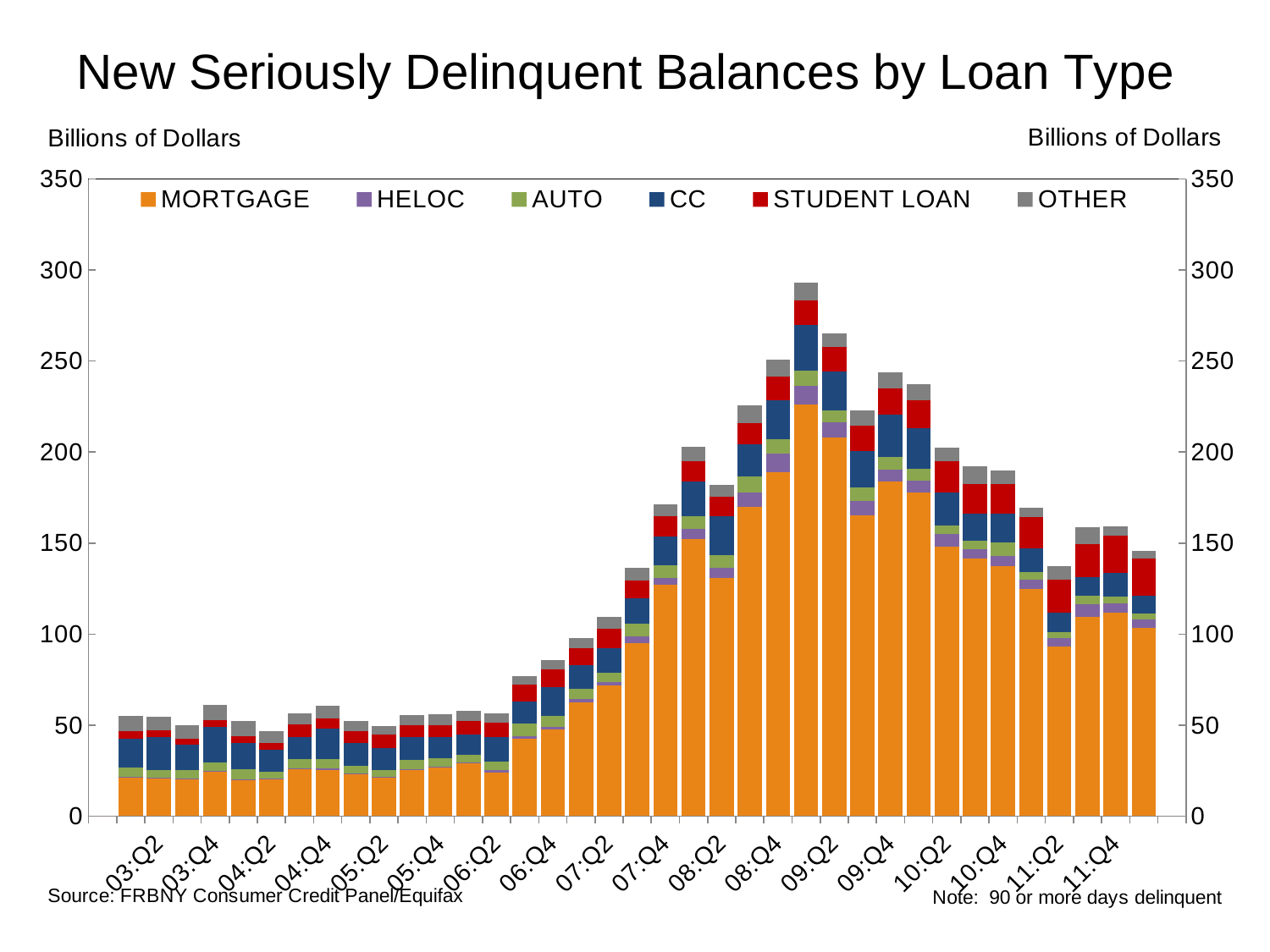
Do the total bar heights generally rise or fall from 06:Q2 to 09:Q2? rise Is the total bar height for 06:Q4 greater or less than 100? less How many series does the legend list? 6 Is the total bar height for 11:Q2 greater or less than 150? less What kind of chart is shown on the slide? Stacked bar chart Is the total bar height for 08:Q2 greater or less than 150? greater Which loan type forms the bottom segment of each stacked bar? MORTGAGE Which quarter has the taller total bar, 09:Q2 or 03:Q2? 09:Q2 What unit is shown on the vertical axis? Billions of Dollars Which quarter has the taller total bar, 08:Q2 or 11:Q2? 08:Q2